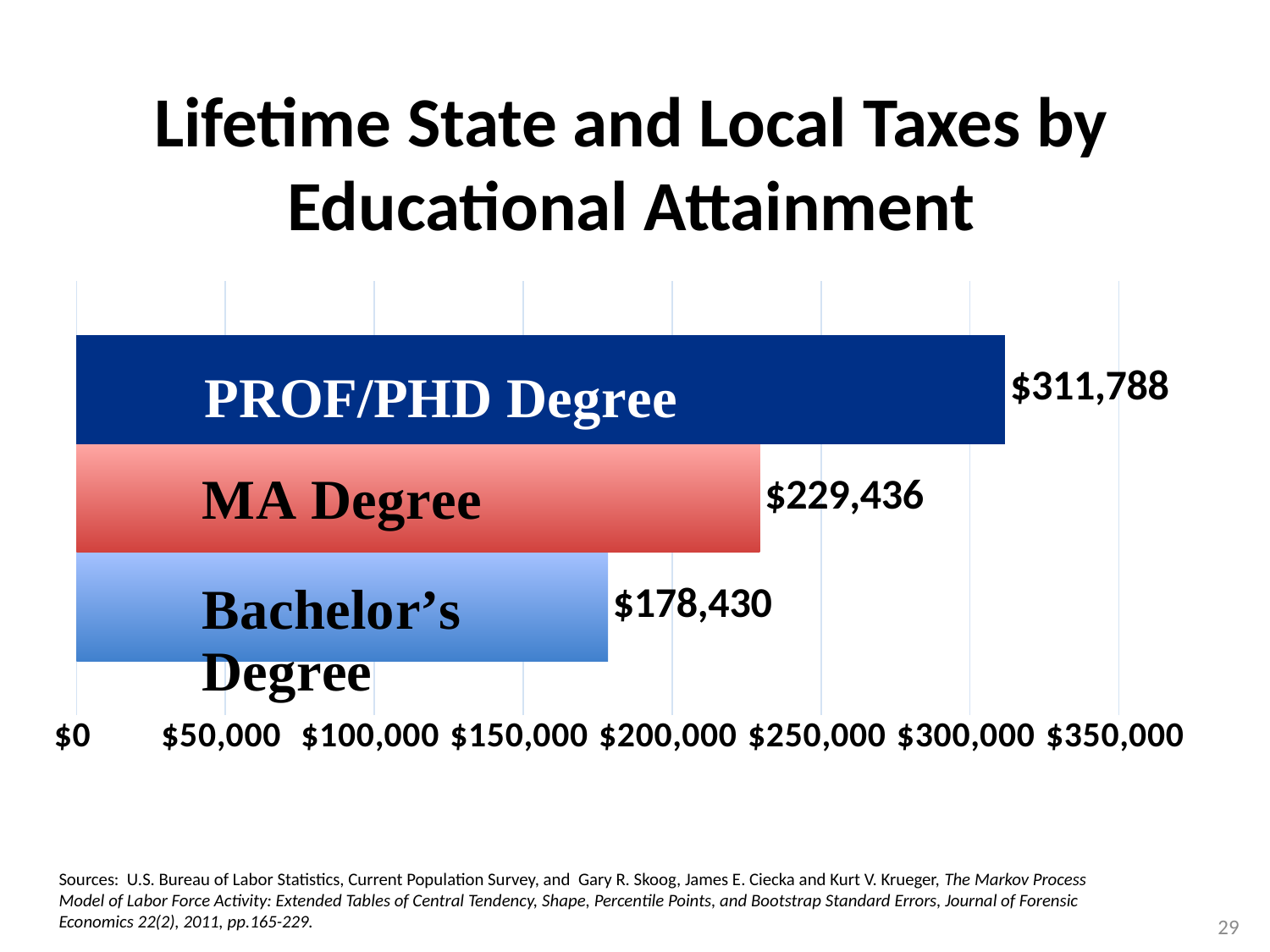
Which category has the highest value? PROF/PHD Degree What is the value for Bachelor's Degree? $178,430 Which category has the lowest value? Bachelor's Degree What is the title of the slide? Lifetime State and Local Taxes by Educational Attainment How many categories are shown in the chart? 3 Is the value for MA Degree greater or less than $200,000? greater What is the value for MA Degree? $229,436 What is the difference between the values for PROF/PHD Degree and MA Degree? $82,352 What is the difference between the values for MA Degree and Bachelor's Degree? $51,006 Which is larger, the value for MA Degree or the value for Bachelor's Degree? MA Degree What kind of chart is shown on the slide? bar chart What is the value for PROF/PHD Degree? $311,788